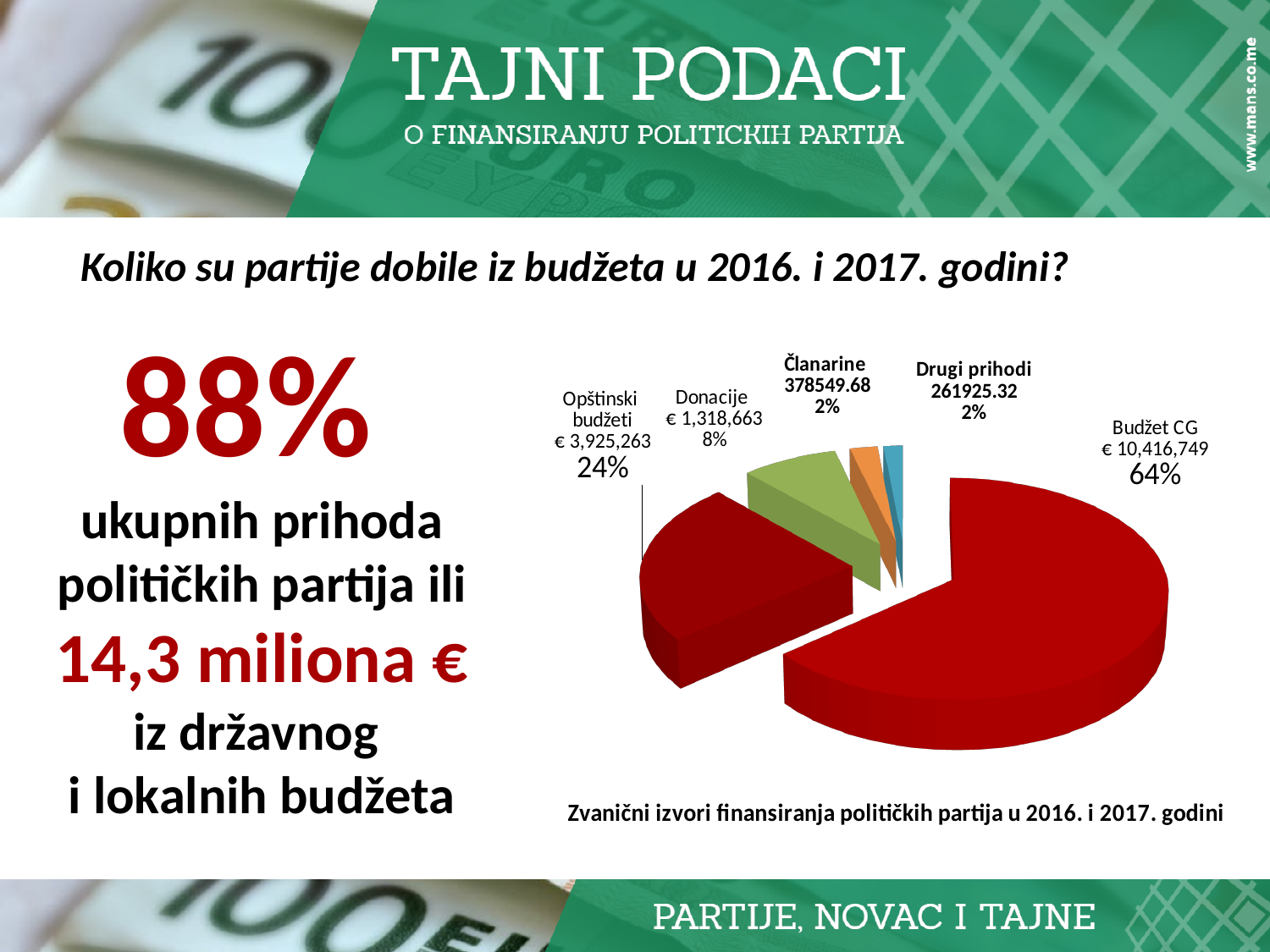
What is the value shown for Opštinski budžeti in the pie chart? € 3,925,263 What share of the pie does Opštinski budžeti represent? 24% What is the value shown for Budžet CG in the pie chart? € 10,416,749 What is the value shown for Donacije in the pie chart? € 1,318,663 What is the title of the pie chart? Zvanični izvori finansiranja političkih partija u 2016. i 2017. godini Which category has the largest slice in the pie chart? Budžet CG What type of chart is shown on the slide? Pie chart How many slices does the pie chart have? 5 What share of the pie does Budžet CG represent? 64% Which is larger, the value for Članarine or the value for Drugi prihodi? Članarine What is the value shown for Članarine in the pie chart? 378549.68 What is the difference between the values for Budžet CG and Opštinski budžeti? € 6,491,486